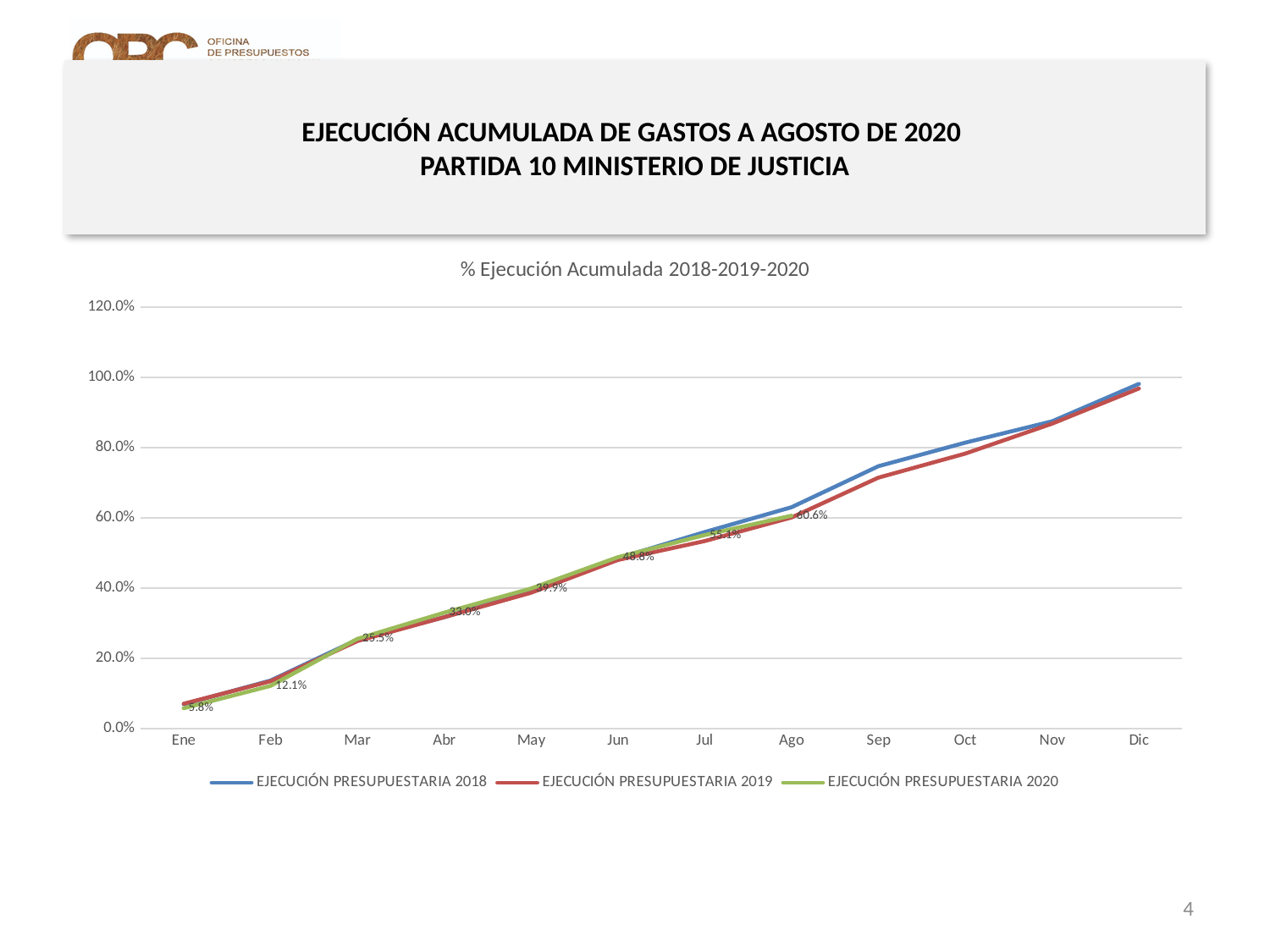
What is the value for EJECUCIÓN PRESUPUESTARIA 2020 in Feb? 12.1% How many series does the legend list? 3 What is the difference between the EJECUCIÓN PRESUPUESTARIA 2020 values for Mar and Feb? 13.4 percentage points What is the value for EJECUCIÓN PRESUPUESTARIA 2020 in Abr? 33.0% What is the value for EJECUCIÓN PRESUPUESTARIA 2020 in Mar? 25.5% What kind of chart is shown on the slide? line chart Is the value for EJECUCIÓN PRESUPUESTARIA 2019 in Oct greater or less than 80.0%? less What is the value for EJECUCIÓN PRESUPUESTARIA 2020 in Jun? 48.8% What is the title of the chart? % Ejecución Acumulada 2018-2019-2020 How many months are shown along the x axis? 12 Do the values for EJECUCIÓN PRESUPUESTARIA 2018 rise or fall from Ene to Dic? rise Is the value for EJECUCIÓN PRESUPUESTARIA 2018 in Dic greater or less than 80.0%? greater